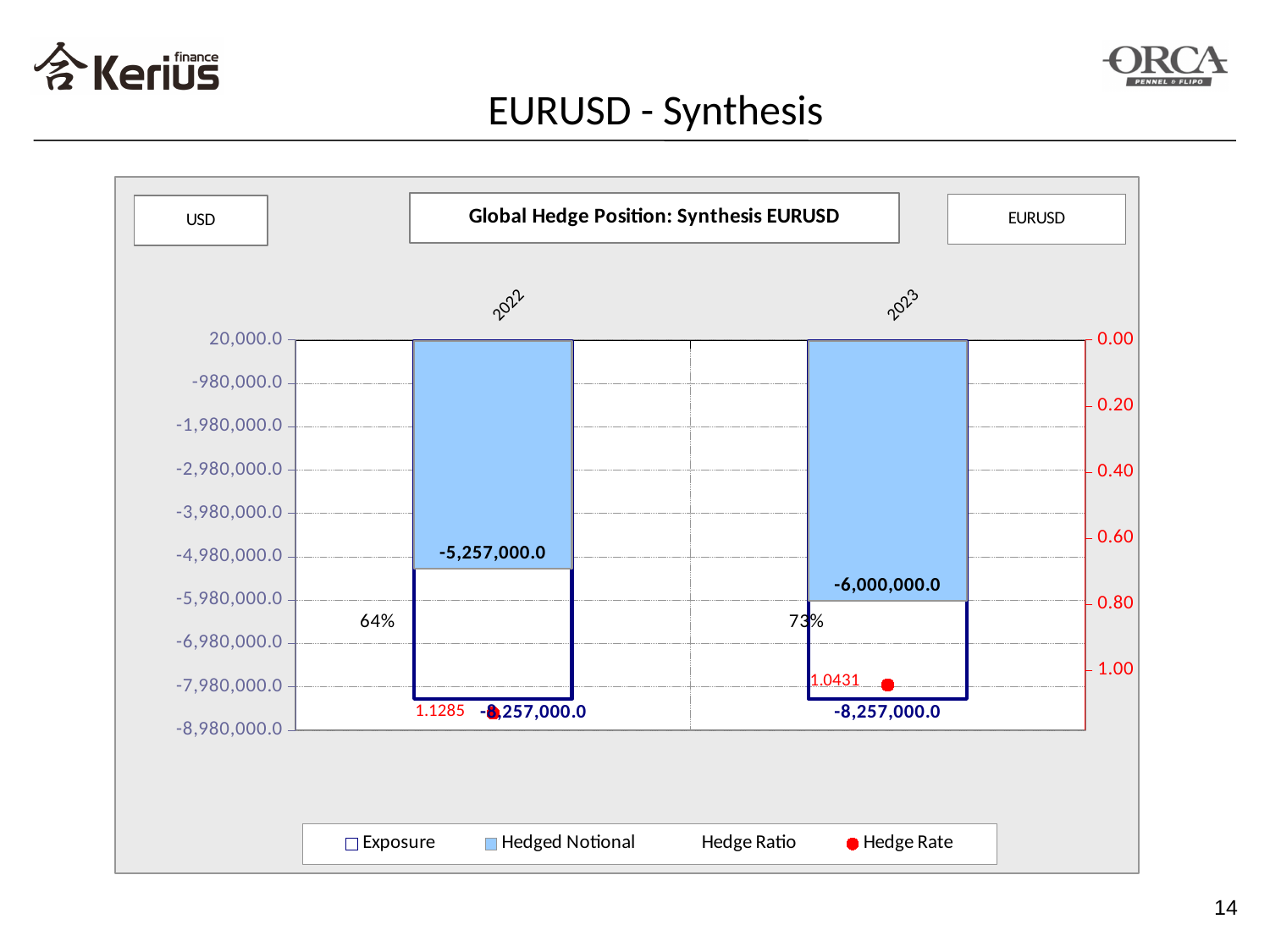
Does the Hedge Ratio rise or fall from 2022 to 2023? rise What is the Hedged Notional value for 2023? -6,000,000.0 What is the Hedged Notional value for 2022? -5,257,000.0 What is the difference between the Hedged Notional values for 2023 and 2022? 743,000.0 Which year has the higher Hedge Ratio, 2022 or 2023? 2023 How many series does the legend list? 4 What is the Hedge Rate for 2022? 1.1285 What is the Hedge Rate for 2023? 1.0431 How many years are shown on the x axis? 2 What is the Exposure value for 2022? -8,257,000.0 What is the title of the chart? Global Hedge Position: Synthesis EURUSD What is the Hedge Ratio for 2023? 73%